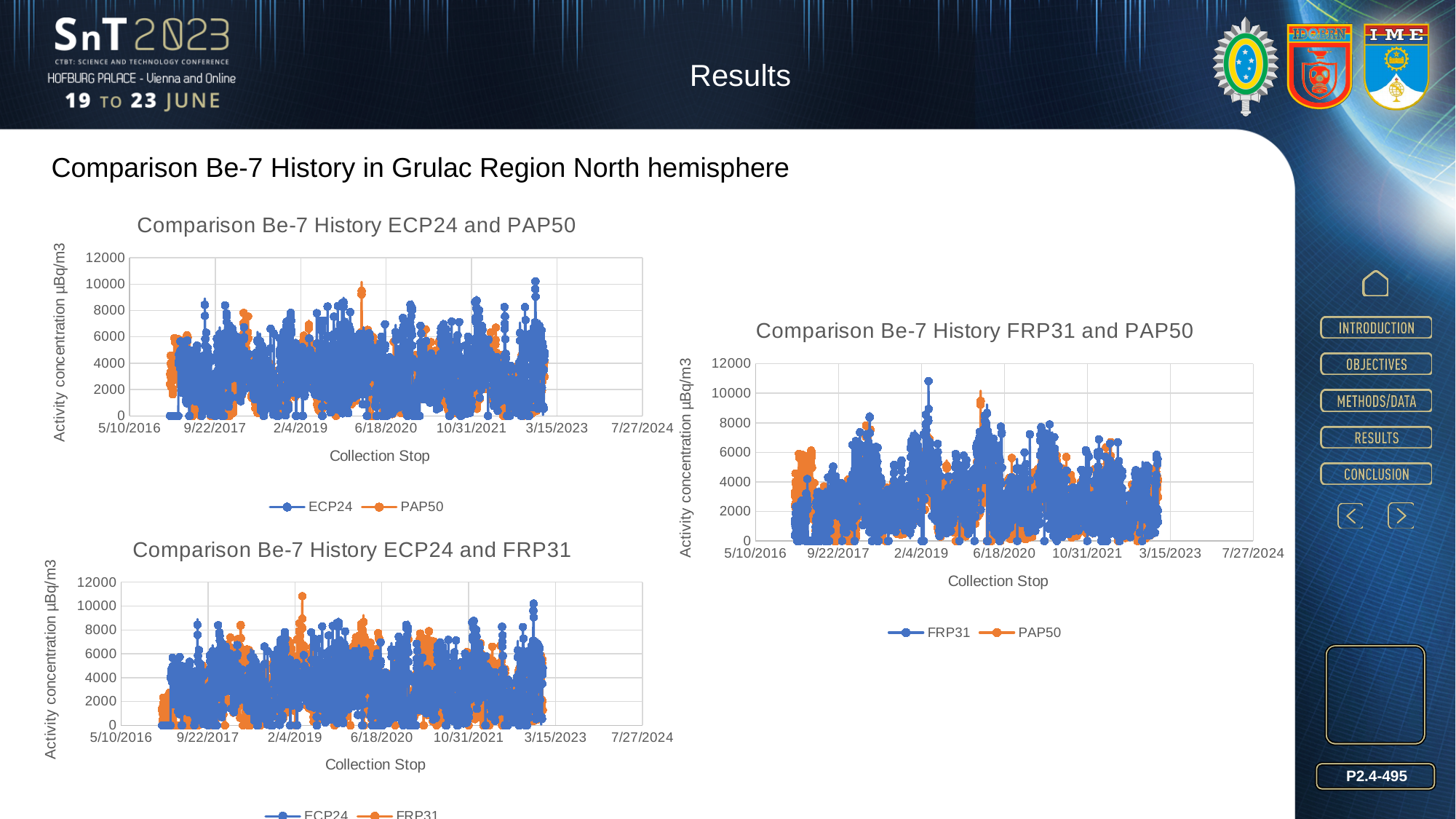
In the chart titled "Comparison Be-7 History ECP24 and PAP50", does any plotted value exceed 12000? No In the chart titled "Comparison Be-7 History ECP24 and PAP50", is the highest ECP24 value greater or less than 10000? greater In the chart titled "Comparison Be-7 History ECP24 and FRP31", is the highest FRP31 value greater or less than 10000? greater In the chart titled "Comparison Be-7 History ECP24 and PAP50", how many series does the legend list? 2 Which series are listed in the legend of the chart titled "Comparison Be-7 History ECP24 and PAP50"? ECP24 and PAP50 In the chart titled "Comparison Be-7 History FRP31 and PAP50", how many series does the legend list? 2 What kind of chart is "Comparison Be-7 History ECP24 and FRP31"? Line chart What is the y-axis label of the chart titled "Comparison Be-7 History FRP31 and PAP50"? Activity concentration µBq/m3